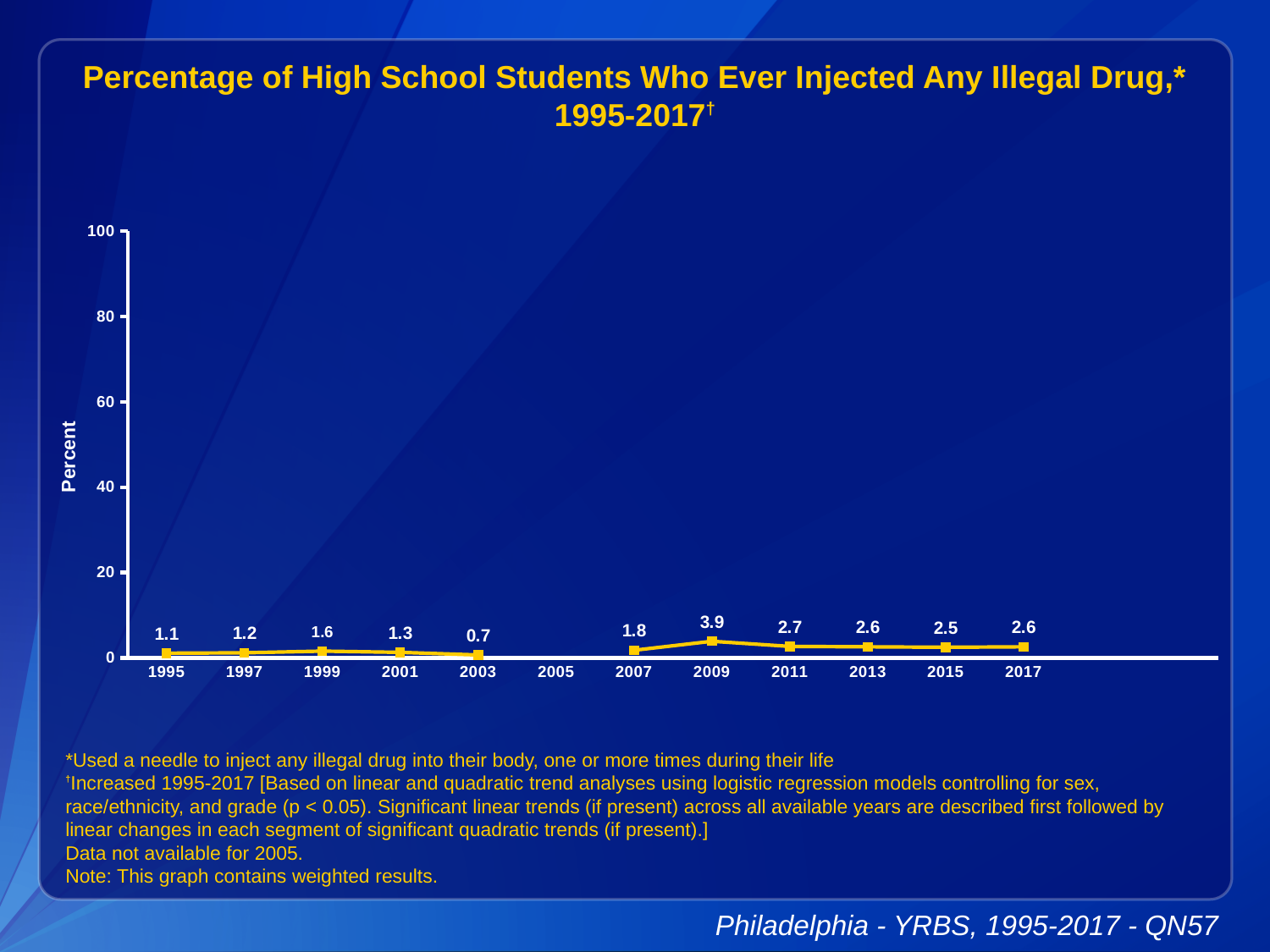
What kind of chart is shown on the slide? line chart What percentage of high school students had ever injected any illegal drug in 2009? 3.9 What is the value plotted for 2017? 2.6 What is the difference between the 2009 value and the 2007 value? 2.1 Which year has the lowest percentage? 2003 What is the label on the y axis? Percent Which year has a larger value, 1999 or 2001? 1999 Which year on the x axis has no data point plotted? 2005 What is the value plotted for 2003? 0.7 Which year has the highest percentage? 2009 Is the value for 2011 greater or less than 20? less How many years have a data point plotted on the chart? 11